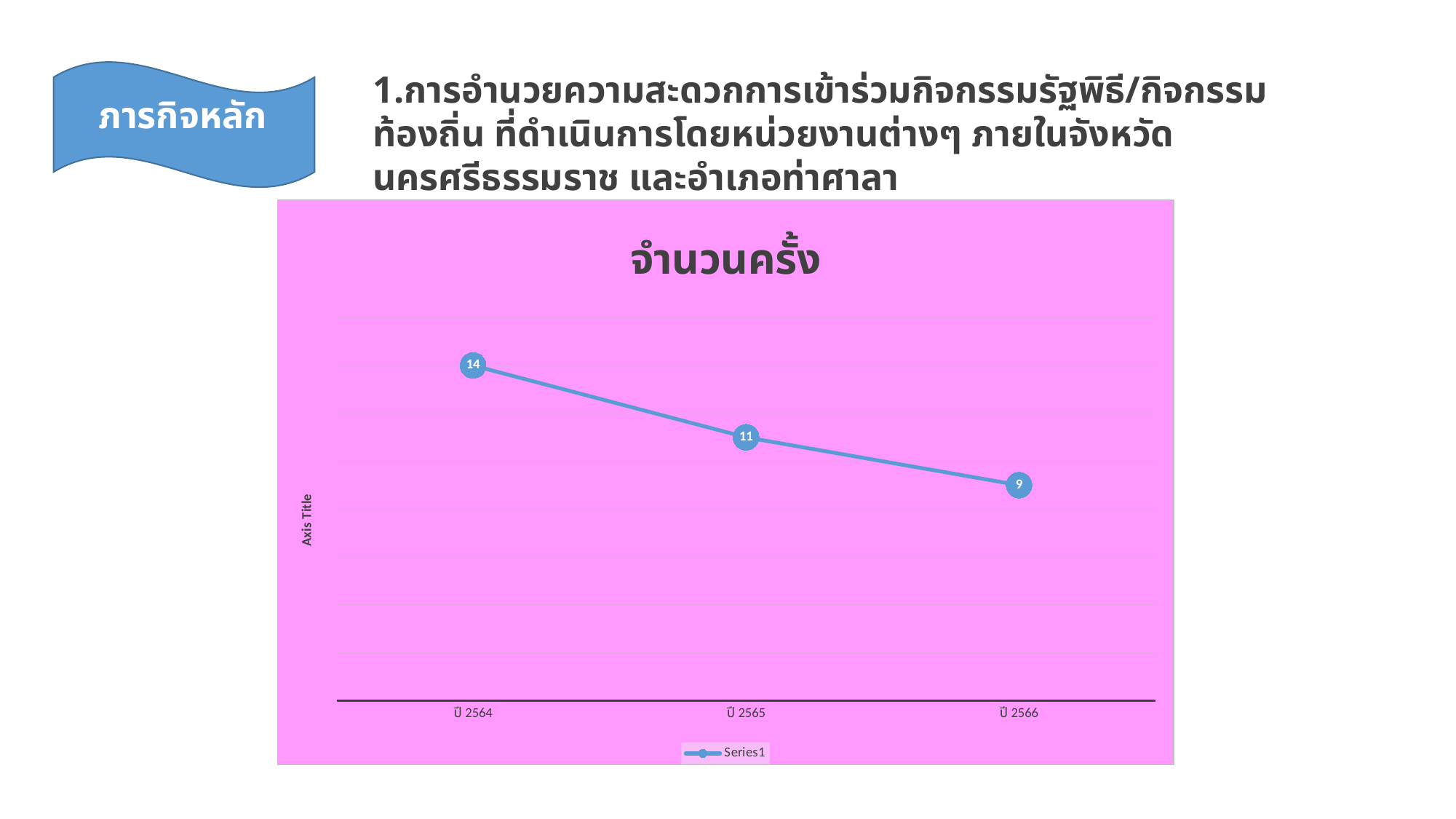
Which is larger, the value for ปี 2565 or the value for ปี 2566? ปี 2565 Which year has the highest value? ปี 2564 What kind of chart is shown? line chart What is the value for ปี 2566? 9 What is the difference between the values for ปี 2564 and ปี 2566? 5 What is the value for ปี 2564? 14 Do the values rise or fall from ปี 2564 to ปี 2566? fall How many series does the legend list? 1 What is the difference between the values for ปี 2564 and ปี 2565? 3 Which year has the lowest value? ปี 2566 What is the value for ปี 2565? 11 How many data points are plotted on the chart? 3